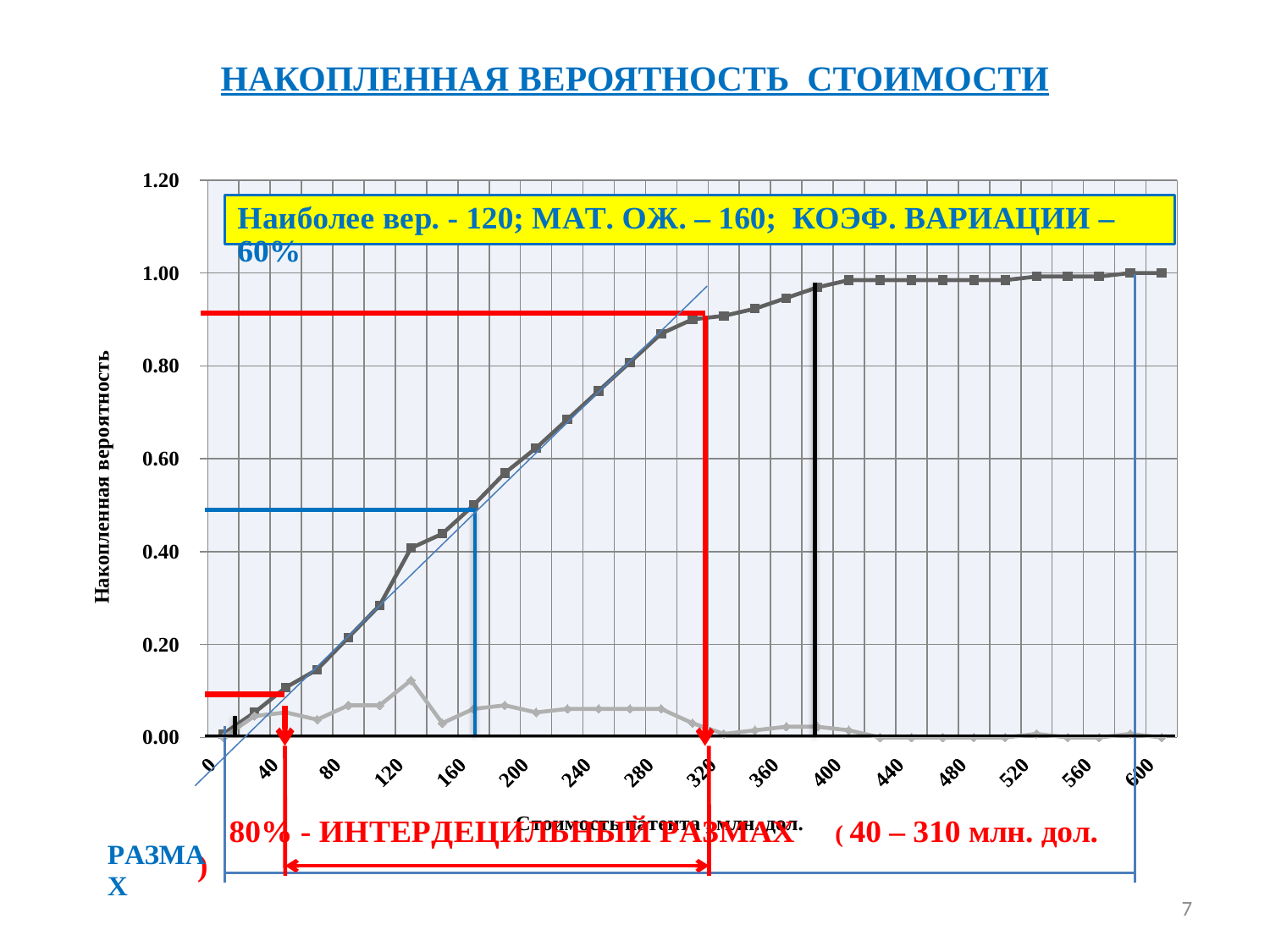
Is the cumulative probability at a patent value of 200 greater or less than 0.40? greater Is the cumulative probability at a patent value of 480 greater or less than 0.80? greater What is the label of the vertical axis? Накопленная вероятность What kind of chart is shown on the slide? line chart Is the cumulative probability at a patent value of 120 greater or less than 0.60? less Which is larger: the cumulative probability at a patent value of 80 or at 280? 280 What is the title of the chart on the slide? НАКОПЛЕННАЯ ВЕРОЯТНОСТЬ СТОИМОСТИ Does the dark cumulative probability line rise or fall as the patent value increases along the x axis? rises